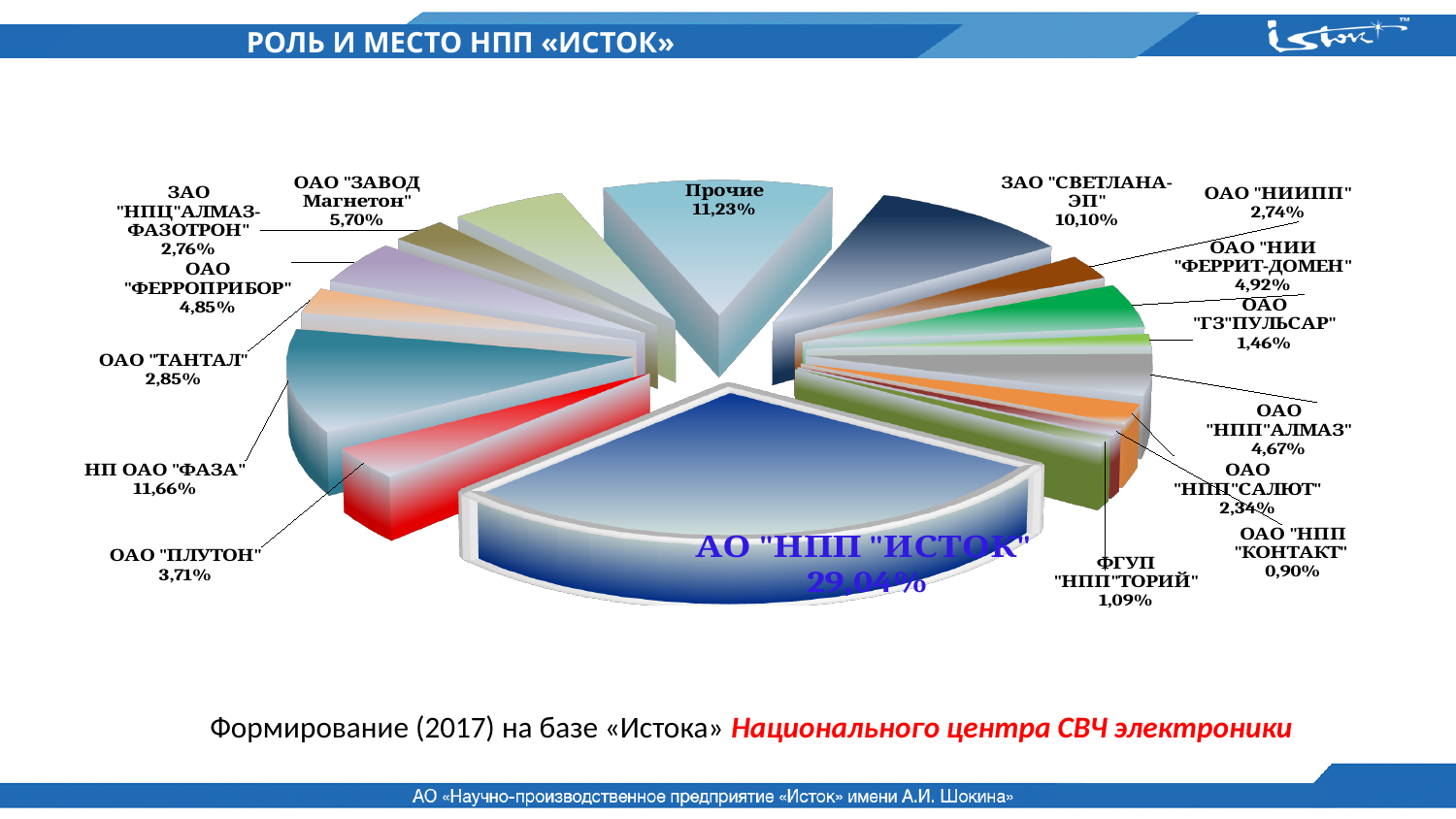
Which slice of the pie is the largest? АО "НПП "ИСТОК" What kind of chart is shown on the slide? pie chart How many slices does the pie chart have? 16 Which slice of the pie is the smallest? ОАО "НПП "КОНТАКТ" What is the value shown for НП ОАО "ФАЗА"? 11,66% Which has the larger share, ОАО "ФЕРРОПРИБОР" or ОАО "ТАНТАЛ"? ОАО "ФЕРРОПРИБОР" What share of the pie does АО "НПП "ИСТОК" hold? 29,04% What is the title shown in the header of the slide? РОЛЬ И МЕСТО НПП «ИСТОК» What is the difference between the shares of АО "НПП "ИСТОК" and НП ОАО "ФАЗА"? 17,38% What is the value shown for ОАО "ЗАВОД Магнетон"? 5,70% Which has the larger share, Прочие or ЗАО "СВЕТЛАНА-ЭП"? Прочие What is the value shown for ЗАО "СВЕТЛАНА-ЭП"? 10,10%